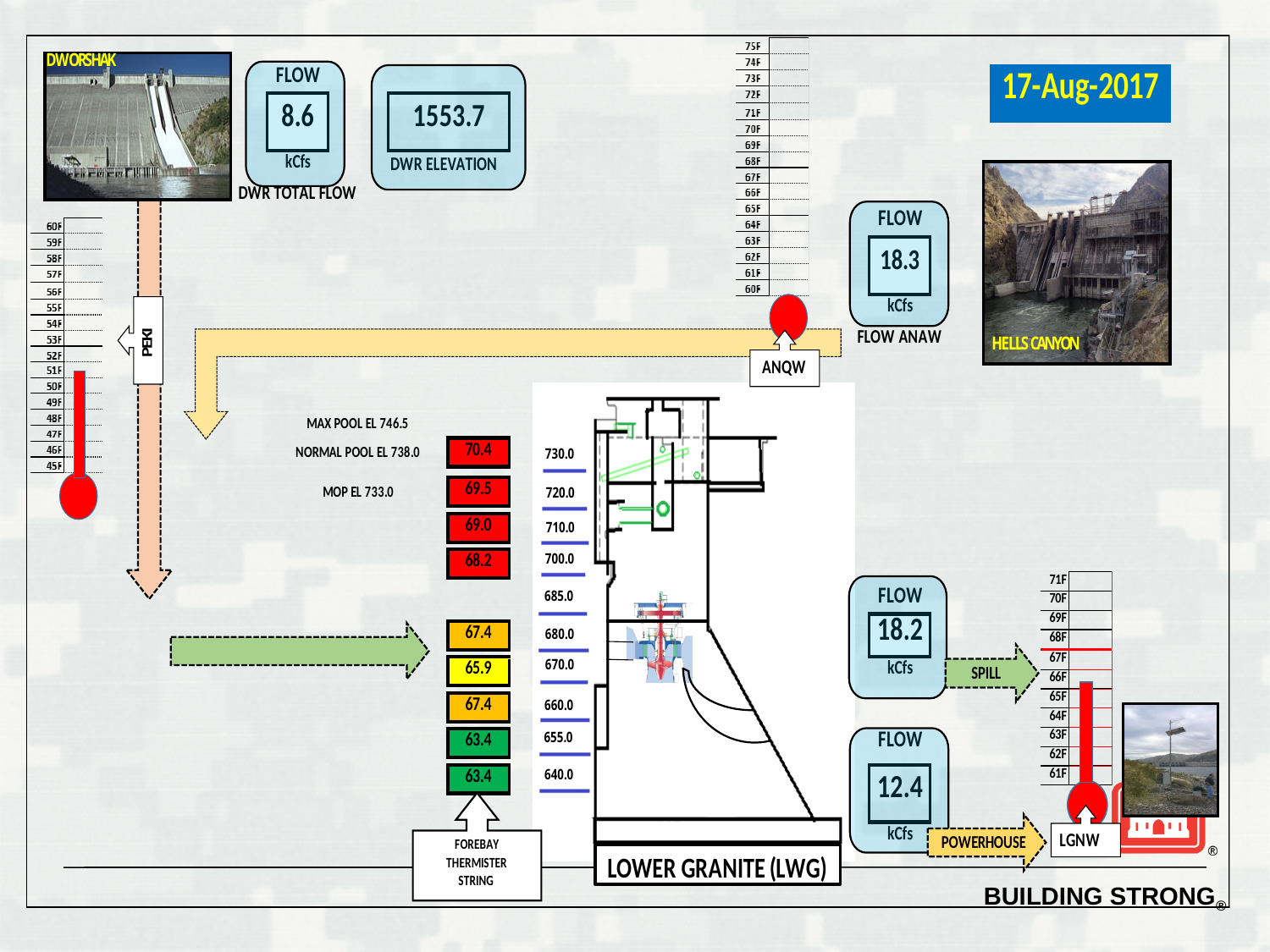
What is the powerhouse flow shown for Lower Granite? 12.4 kCfs What is the difference between the top reading (70.4) and the bottom reading (63.4) on the forebay thermister string? 7.0 What is the flow value shown for ANAW (Flow ANAW)? 18.3 kCfs How many temperature readings are shown on the forebay thermister string? 9 Which is larger at Lower Granite, the spill flow or the powerhouse flow? Spill flow What is the DWR total flow shown for Dworshak? 8.6 kCfs What is the highest temperature reading on the forebay thermister string? 70.4 What is the lowest temperature reading on the forebay thermister string? 63.4 What is the DWR elevation value shown on the slide? 1553.7 What is the spill flow shown for Lower Granite? 18.2 kCfs What is the difference between the spill flow (18.2 kCfs) and the powerhouse flow (12.4 kCfs)? 5.8 kCfs What date is shown on the slide? 17-Aug-2017